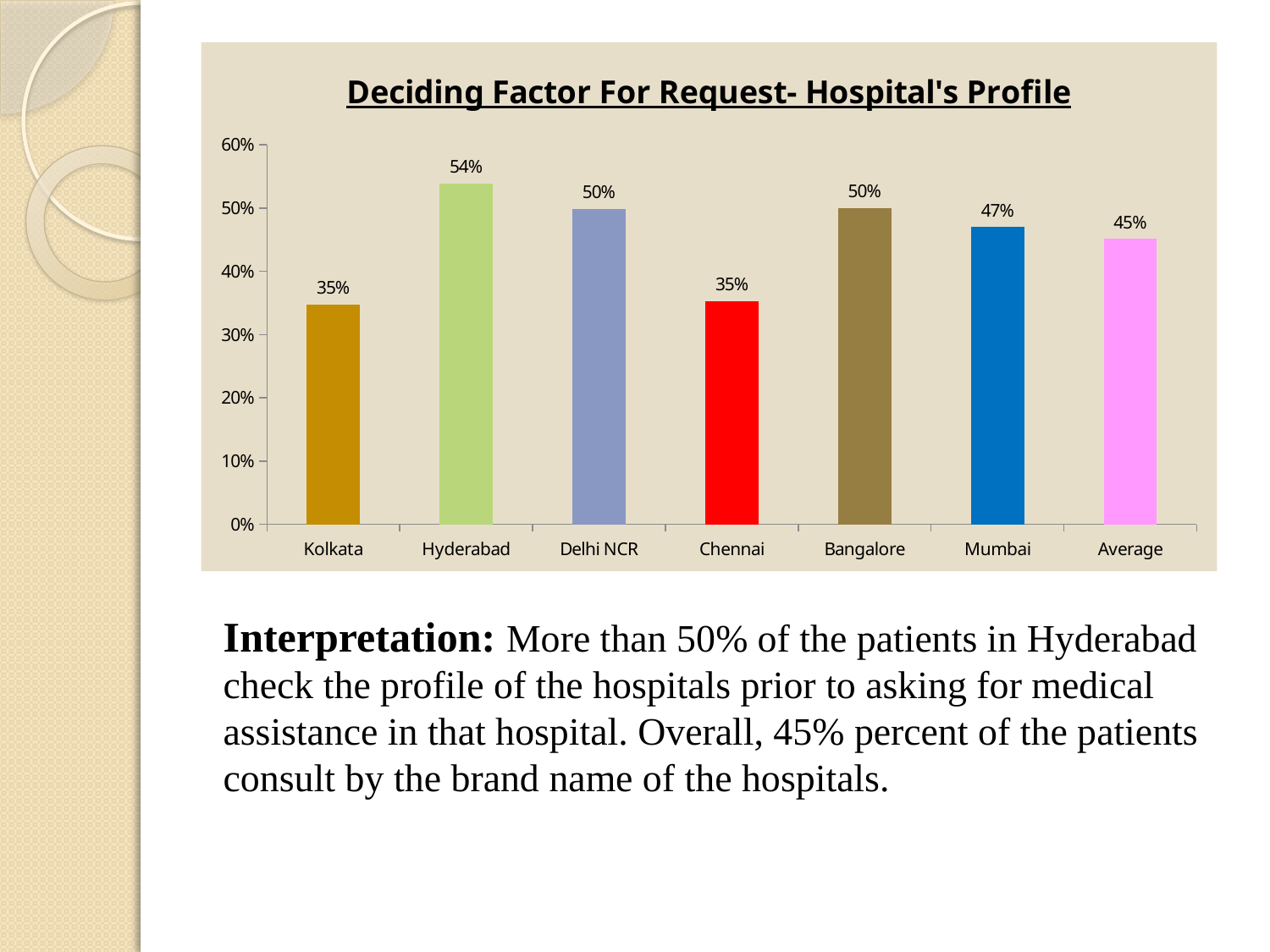
Which city has the highest value? Hyderabad What colour is the bar for Chennai? red What is the difference between the values for Mumbai and Average? 2% How many categories are shown on the x axis? 7 What kind of chart is shown on the slide? bar chart What is the value for Hyderabad? 54% What is the value for Mumbai? 47% What is the value for Average? 45% Is the value for Chennai greater or less than 40%? less What is the title of the chart? Deciding Factor For Request- Hospital's Profile Which is larger, the value for Bangalore or the value for Mumbai? Bangalore What is the difference between the values for Hyderabad and Kolkata? 19%